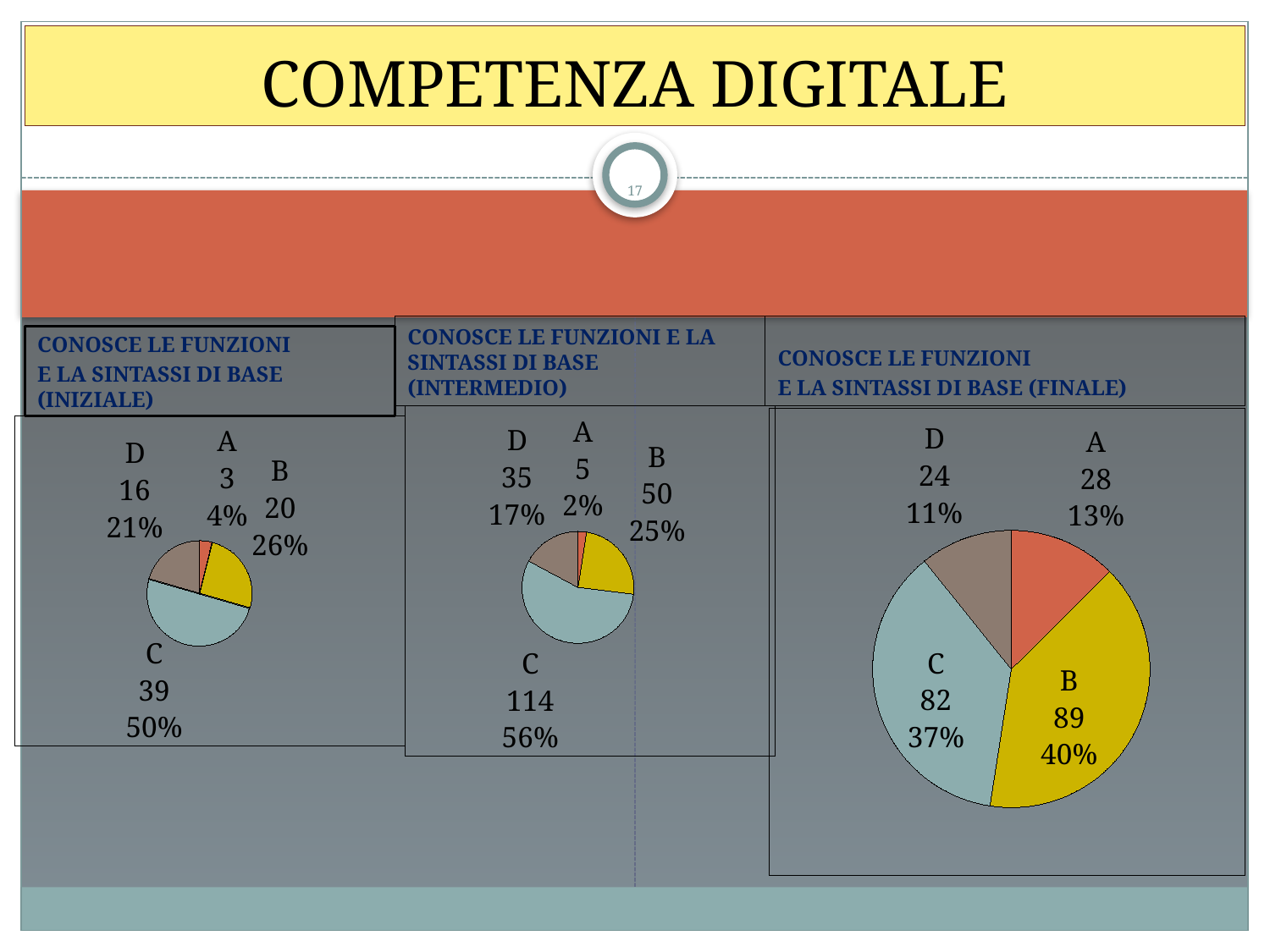
In the INTERMEDIO chart (middle), what is the value for category C? 114 In the INTERMEDIO chart (middle), what percentage share does category D have? 17% In the FINALE chart (right), which is larger, the value for B or the value for C? B In the FINALE chart (right), what percentage share does category C have? 37% What type of chart is used in the INIZIALE chart (left)? Pie chart In the FINALE chart (right), what is the value for category A? 28 In the FINALE chart (right), which category has the highest value? B In the INIZIALE chart (left), what is the value for category C? 39 In the INTERMEDIO chart (middle), what is the difference between the values for C and B? 64 In the INIZIALE chart (left), what percentage share does category B have? 26% How many categories does the FINALE chart (right) show? 4 In the INIZIALE chart (left), which category has the lowest value? A